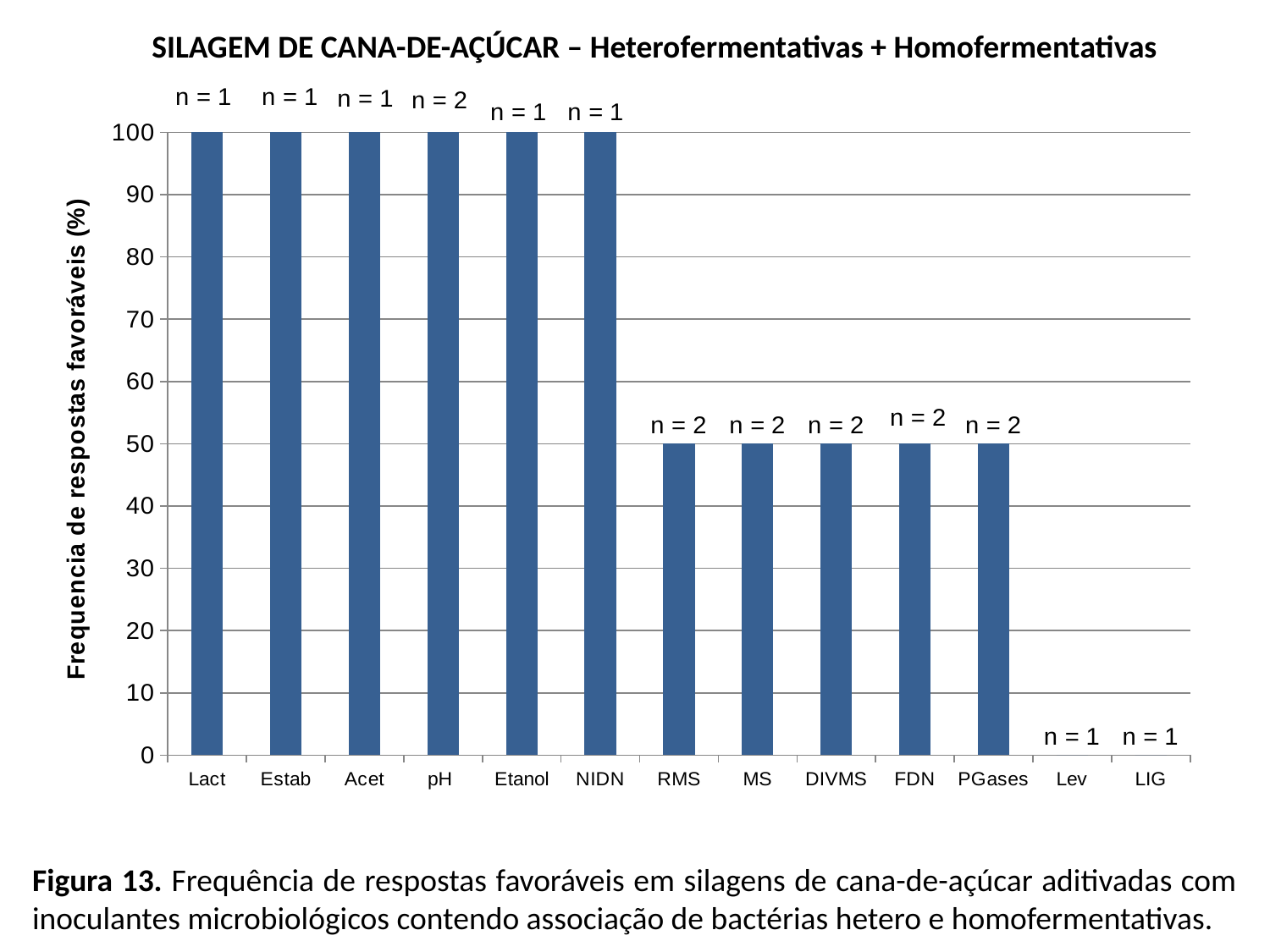
What is the n value printed above the pH bar? n = 2 Is the value for DIVMS greater or less than 70? less What is the frequency of favourable responses (%) for LIG? 0 What is the frequency of favourable responses (%) for Lact? 100 What is the difference between the values for NIDN and FDN? 50 What is the frequency of favourable responses (%) for RMS? 50 What is the label of the y axis? Frequencia de respostas favoráveis (%) Which has a larger value, Acet or MS? Acet What is the n value printed above the Etanol bar? n = 1 How many categories have a value of 100%? 6 What type of chart is shown on the slide? bar chart How many categories are shown on the x axis of the chart? 13